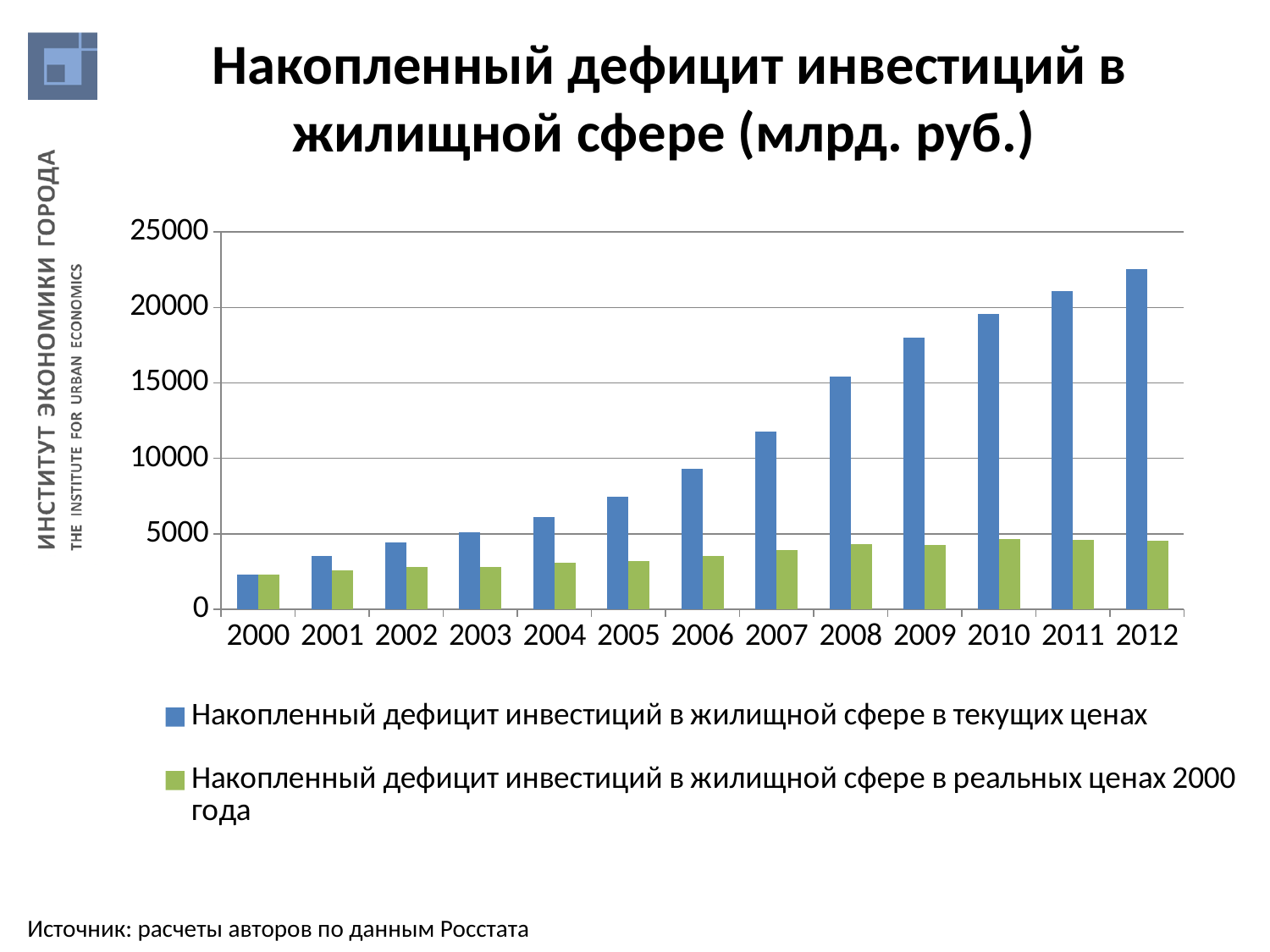
Is the value for 2012 in real 2000 prices (в реальных ценах 2000 года) greater or less than 5000? less Which year has the lowest value for the accumulated investment deficit in current prices (в текущих ценах)? 2000 What kind of chart is shown on the slide? bar chart What colour are the bars for the series in real 2000 prices (в реальных ценах 2000 года)? green Which year has the highest value for the accumulated investment deficit in current prices (Накопленный дефицит инвестиций в жилищной сфере в текущих ценах)? 2012 How many years are shown on the x axis? 13 Is the value for 2012 in current prices (в текущих ценах) greater or less than 20000? greater Does the accumulated investment deficit in current prices (в текущих ценах) rise or fall from 2000 to 2012? rise In 2012, which series has the larger value: current prices (в текущих ценах) or real 2000 prices (в реальных ценах 2000 года)? current prices (в текущих ценах) Is the value for 2007 in current prices (в текущих ценах) greater or less than 10000? greater How many series does the legend list? 2